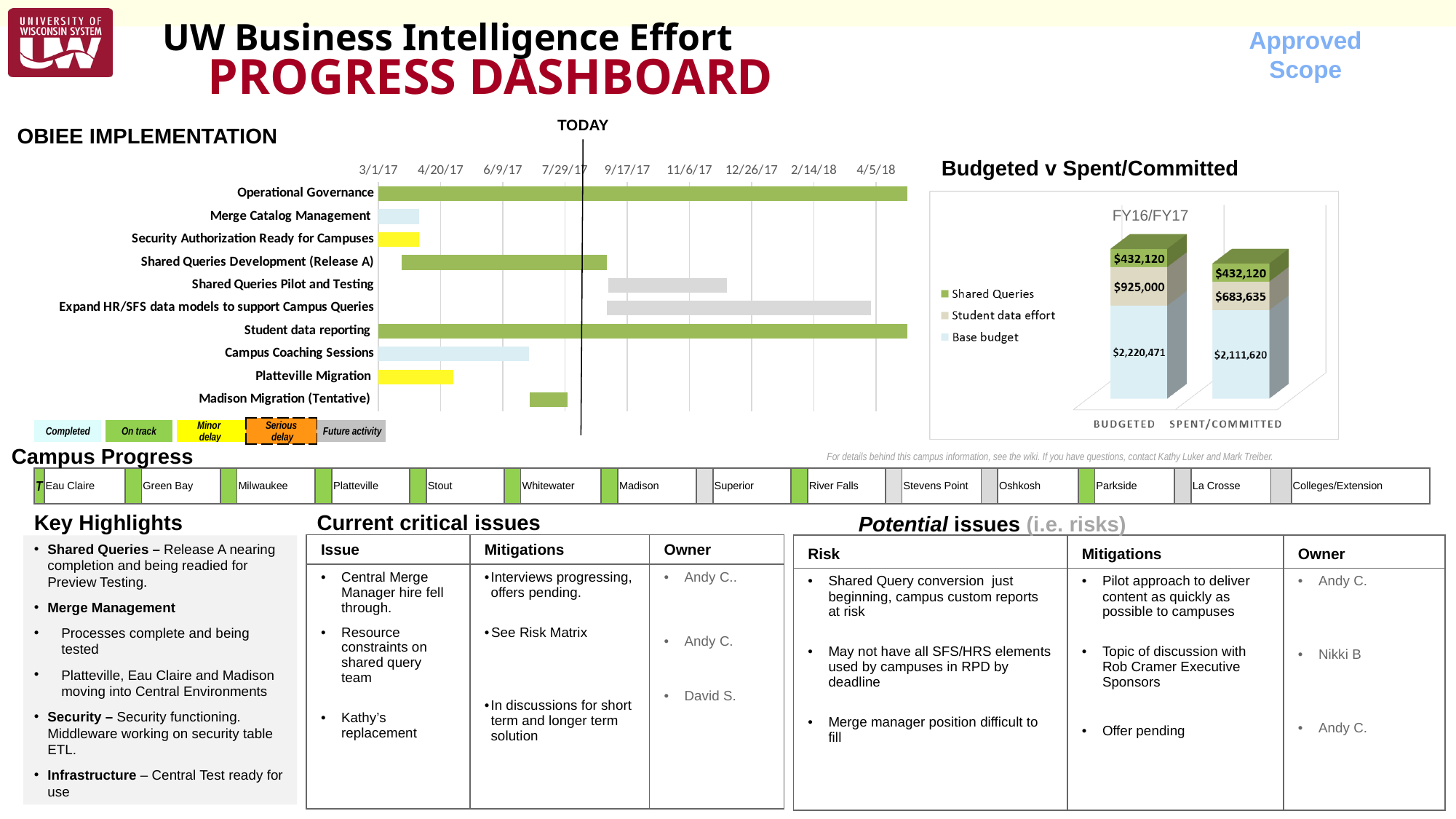
In the Budgeted v Spent/Committed chart, which is larger: the Base budget for Budgeted or for Spent/Committed? Budgeted In the OBIEE Implementation chart, how many status categories does the legend below the chart list? 5 In the Budgeted v Spent/Committed chart, what is the Shared Queries value for the Spent/Committed bar? $432,120 In the Budgeted v Spent/Committed chart, how many series does the legend list? 3 In the Budgeted v Spent/Committed chart, what is the total of the Spent/Committed stacked bar? $3,227,375 In the Budgeted v Spent/Committed chart, what is the Base budget value for the Budgeted bar? $2,220,471 In the OBIEE Implementation chart, how many tasks are listed? 10 What kind of chart is the Budgeted v Spent/Committed chart? Stacked bar chart In the Budgeted v Spent/Committed chart, what is the Student data effort value for the Spent/Committed bar? $683,635 In the Budgeted v Spent/Committed chart, which series has the largest value in the Budgeted bar? Base budget In the Budgeted v Spent/Committed chart, what is the difference between the Budgeted and Spent/Committed Student data effort values? $241,365 In the Budgeted v Spent/Committed chart, what is the total of the Budgeted stacked bar? $3,577,591